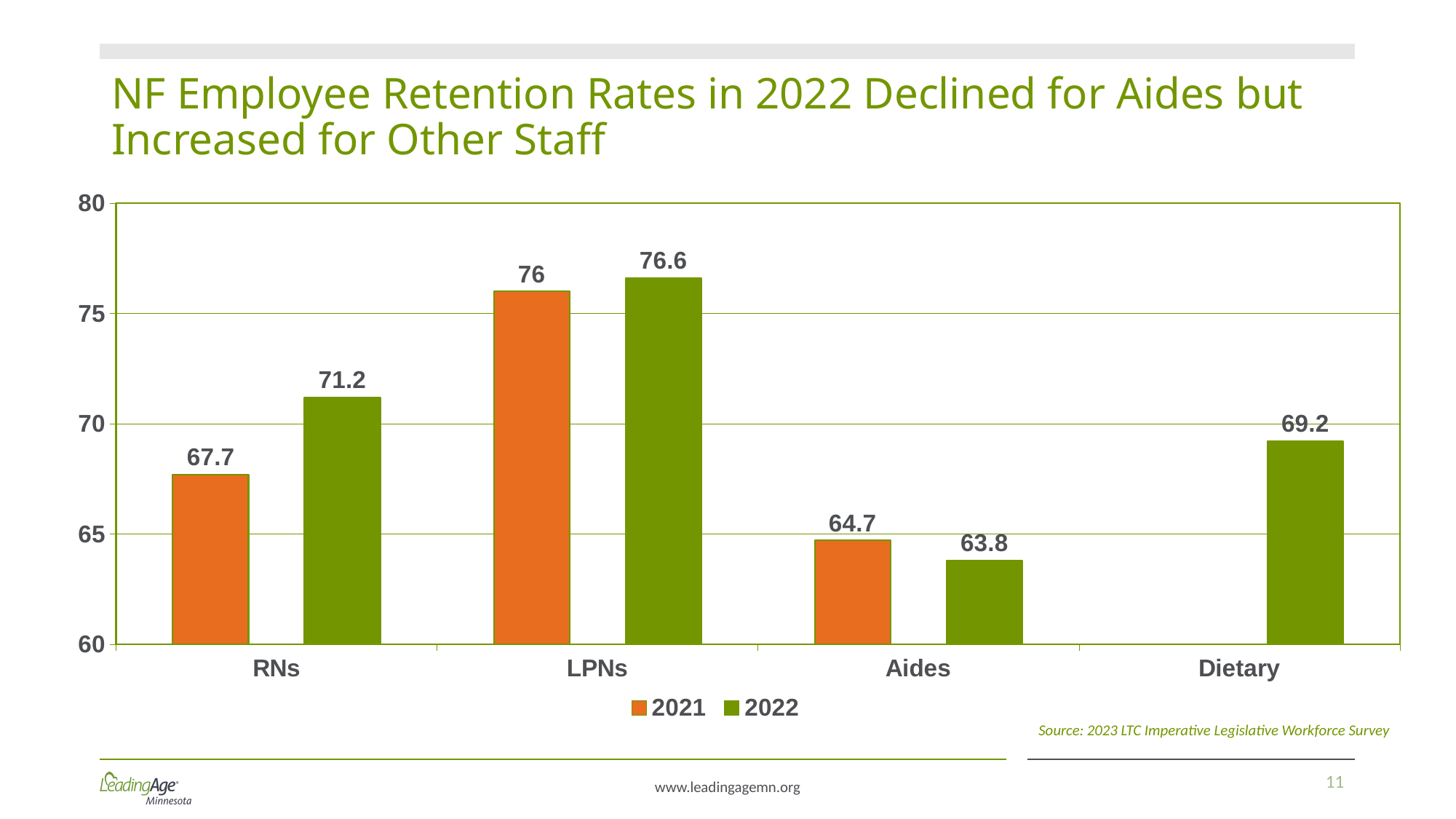
What was the retention rate for LPNs in 2022? 76.6 What was the retention rate for Dietary staff in 2022? 69.2 How many staff categories are shown on the x axis? 4 Which category had the highest retention rate in 2022? LPNs Is the 2022 retention rate for Dietary staff greater or less than 70? less How many series does the legend list? 2 What was the retention rate for Aides in 2022? 63.8 Which was larger, the 2021 or the 2022 retention rate for Aides? 2021 What was the retention rate for RNs in 2021? 67.7 By how much did the retention rate for RNs change from 2021 to 2022? 3.5 What kind of chart is shown on the slide? bar chart